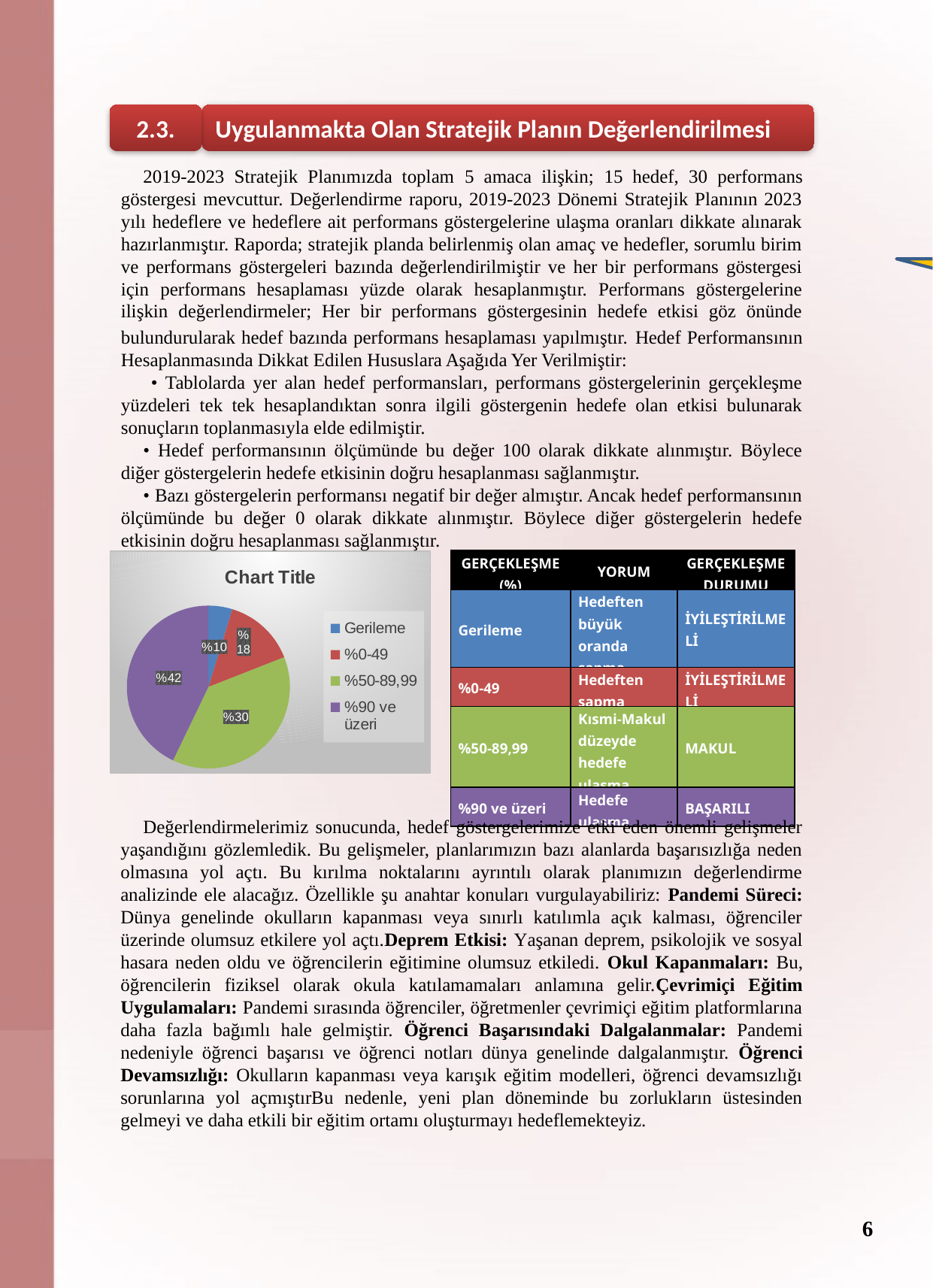
What value is shown for the %0-49 slice? %18 What kind of chart is shown on the slide? pie chart How many slices does the pie chart have? 4 Which colour represents the %0-49 category in the legend? red What value is shown for the %50-89,99 slice? %30 What value is shown for the %90 ve üzeri slice? %42 Which category has the largest slice of the pie? %90 ve üzeri Which is larger, the %0-49 slice or the %50-89,99 slice? %50-89,99 What value is shown for the Gerileme slice? %10 Which category has the smallest slice of the pie? Gerileme What is the title of the chart? Chart Title What is the difference between the %90 ve üzeri value and the %50-89,99 value? %12